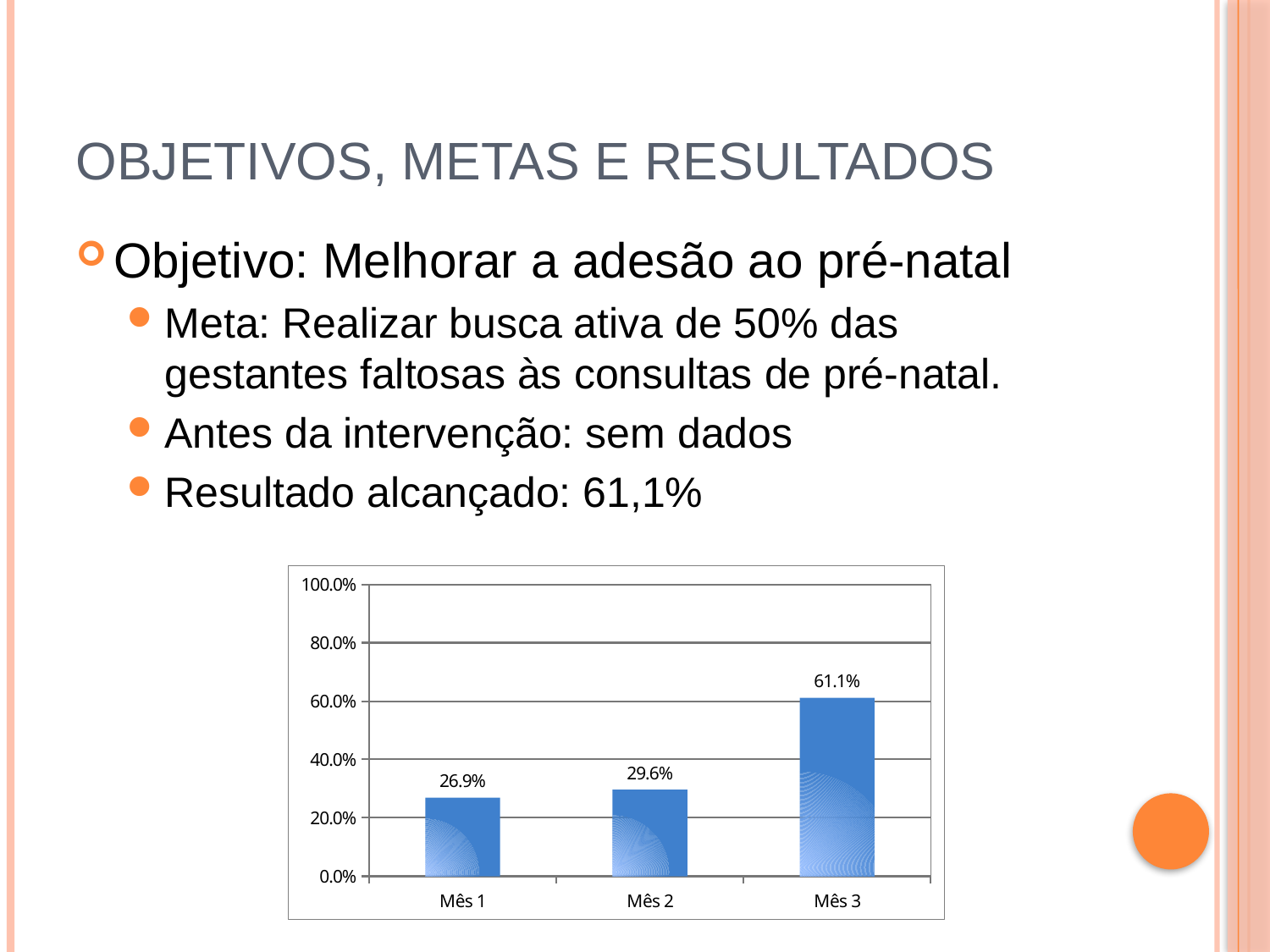
What is the value for Mês 1? 26.9% How many categories are shown on the x axis? 3 What kind of chart is shown on the slide? bar chart Do the values rise or fall from Mês 1 to Mês 3? rise Which is larger, the value for Mês 1 or the value for Mês 3? Mês 3 What is the value for Mês 2? 29.6% Is the value for Mês 3 greater or less than 40.0%? greater What is the difference between the values for Mês 2 and Mês 1? 2.7% What is the difference between the values for Mês 3 and Mês 2? 31.5% Which month has the highest value? Mês 3 What is the value for Mês 3? 61.1% Which month has the lowest value? Mês 1